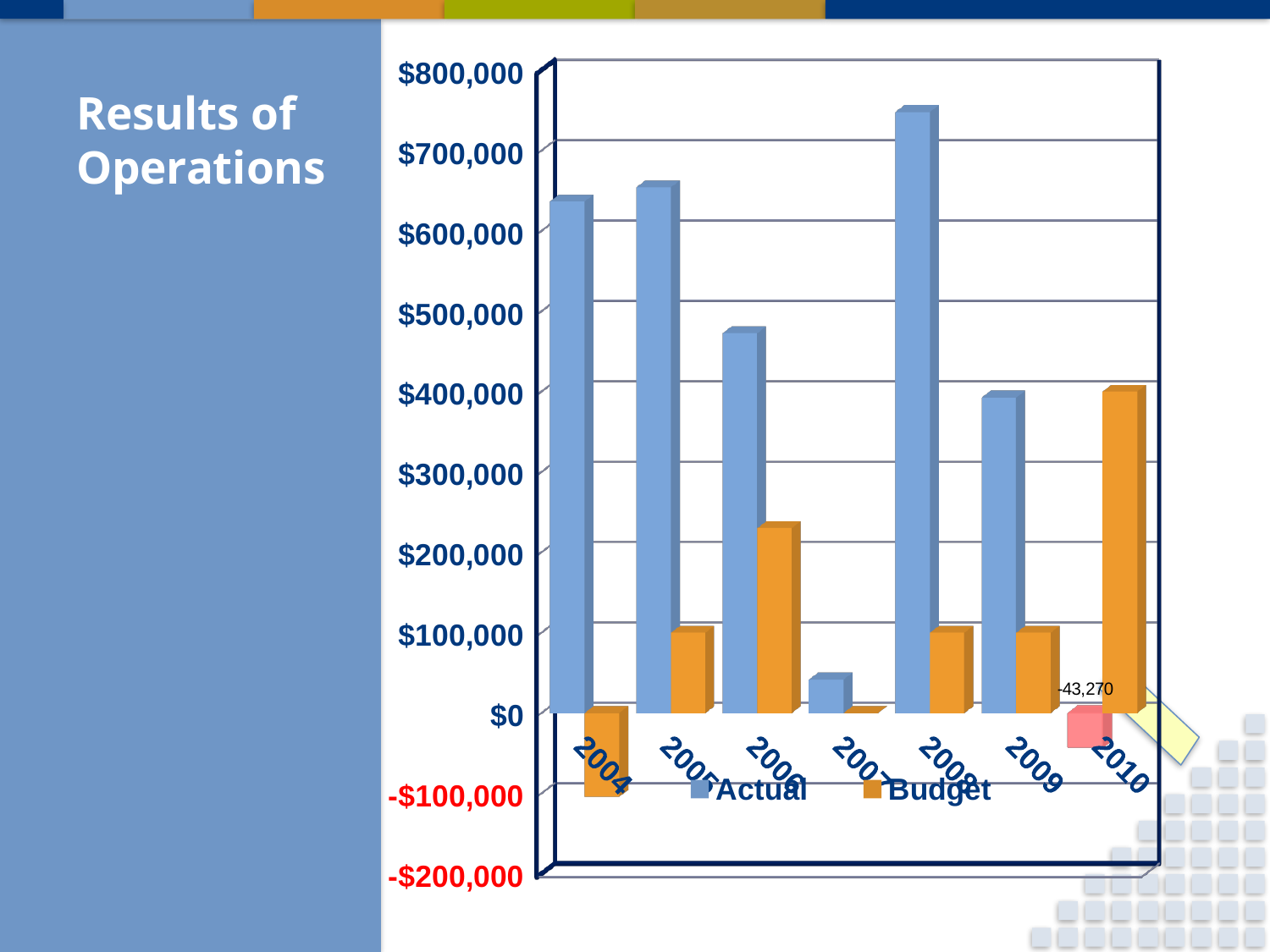
Which year has the lowest Budget value? 2004 What are the two entries in the legend? Actual and Budget How many years are shown on the x axis? 7 Is the Actual value for 2004 greater or less than $500,000? greater Which year has the highest Budget value? 2010 Is the Actual value for 2007 greater or less than $100,000? less What kind of chart is shown on the slide? bar chart What is the Actual value for 2010? -43,270 How many series does the legend list? 2 Which year has the lowest Actual value? 2010 For 2006, which is larger, Actual or Budget? Actual Which year has the highest Actual value? 2008